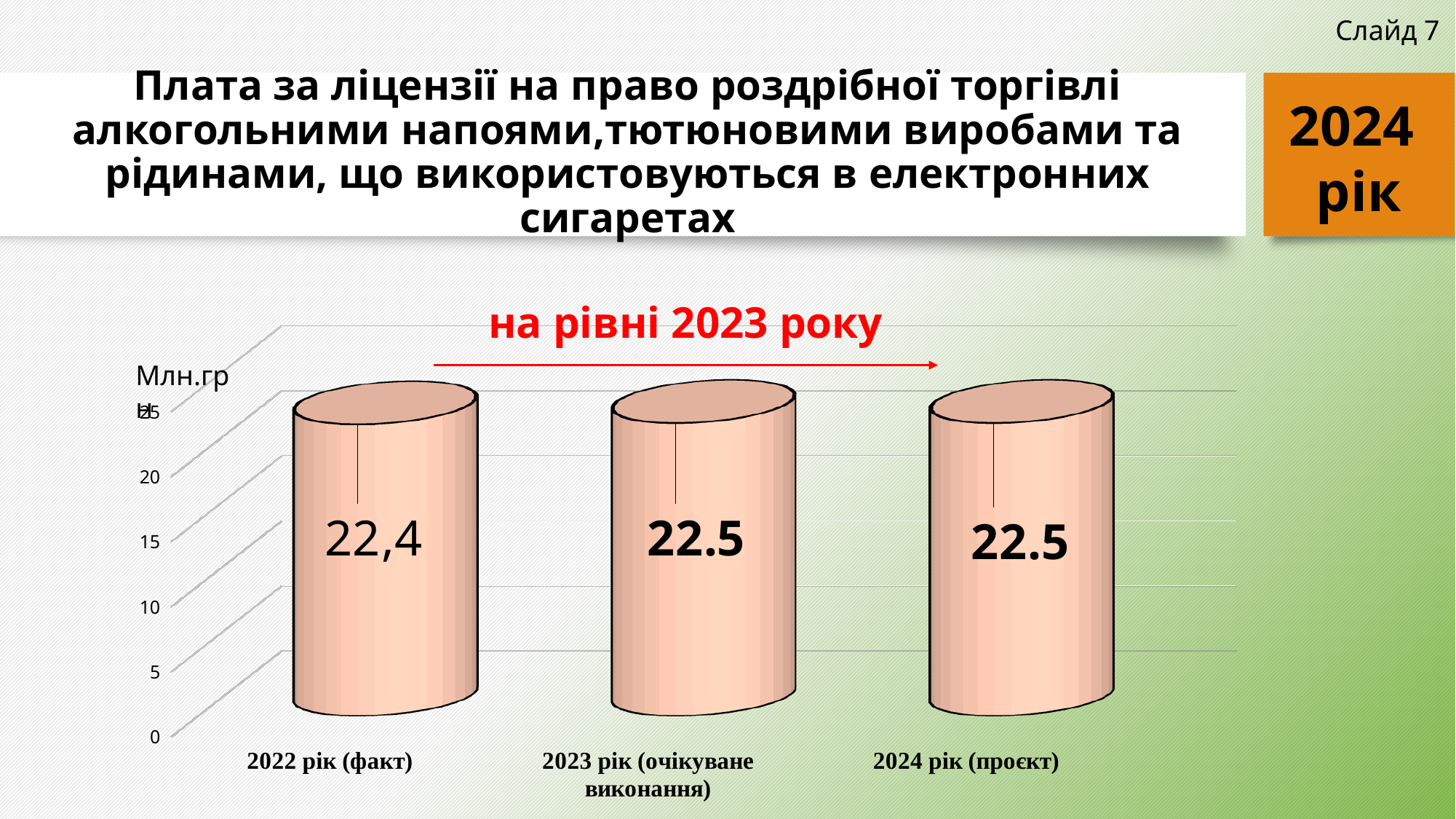
Is the value for 2022 рік (факт) greater or less than 20? greater What is the difference between the values for 2024 рік (проєкт) and 2023 рік (очікуване виконання)? 0 How many categories are shown on the chart? 3 What unit is shown on the vertical axis of the chart? Млн.грн What is the difference between the values for 2023 рік (очікуване виконання) and 2022 рік (факт)? 0.1 What is the value for 2022 рік (факт)? 22,4 Is the value for 2024 рік (проєкт) greater or less than 25? less What does the red annotation above the chart say? на рівні 2023 року What is the value for 2024 рік (проєкт)? 22.5 What is the value for 2023 рік (очікуване виконання)? 22.5 What kind of chart is shown on the slide? bar chart